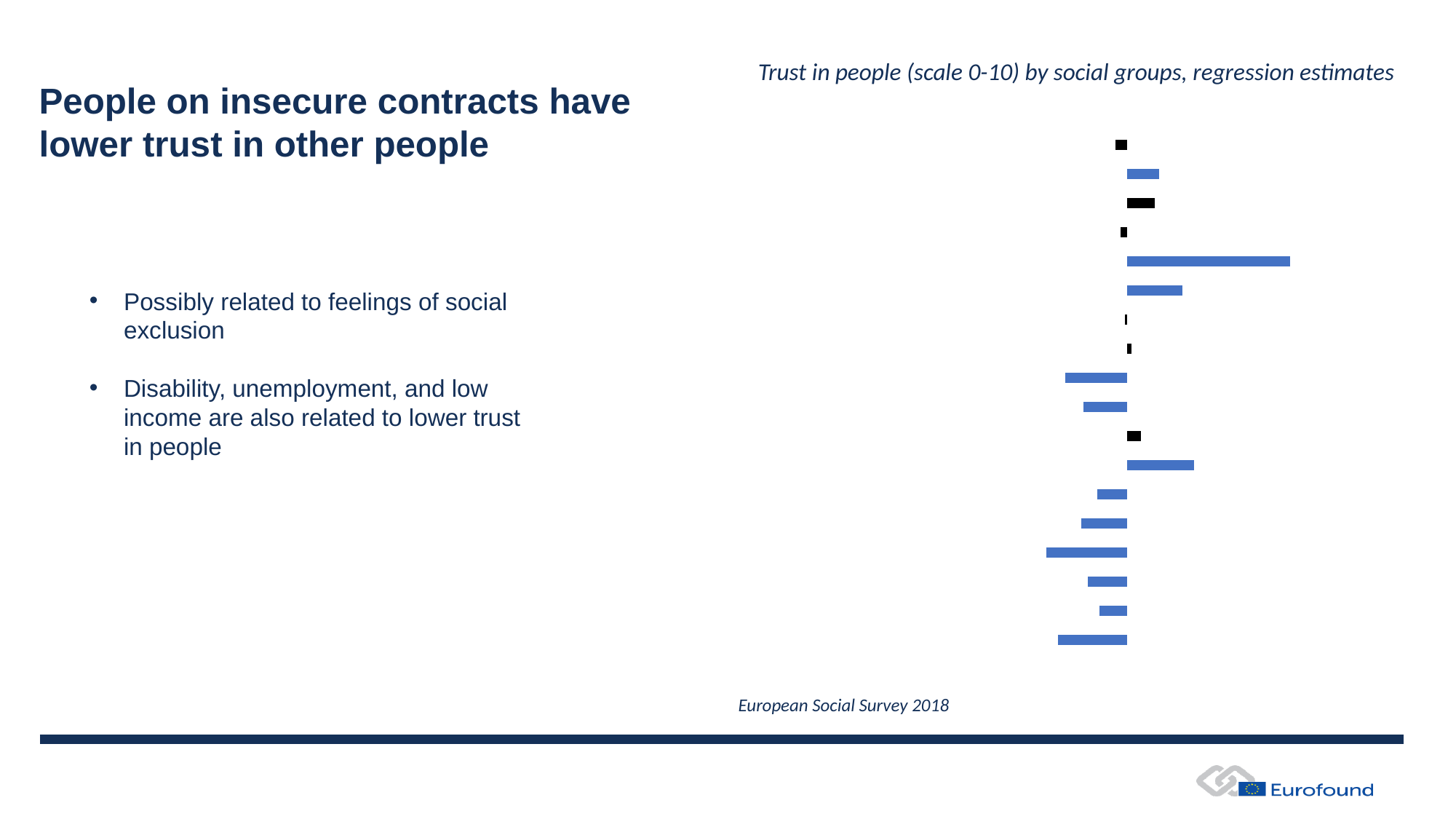
Does the chart display numeric data labels on its bars? No Are the bars in the chart oriented horizontally or vertically? Horizontally What data source is cited below the chart? European Social Survey 2018 What kind of chart is shown on the slide? Bar chart How many bars are plotted in the chart? 18 What is the title of the chart on the slide? Trust in people (scale 0-10) by social groups, regression estimates Does the longest bar in the chart extend to the right or to the left of the baseline? Right